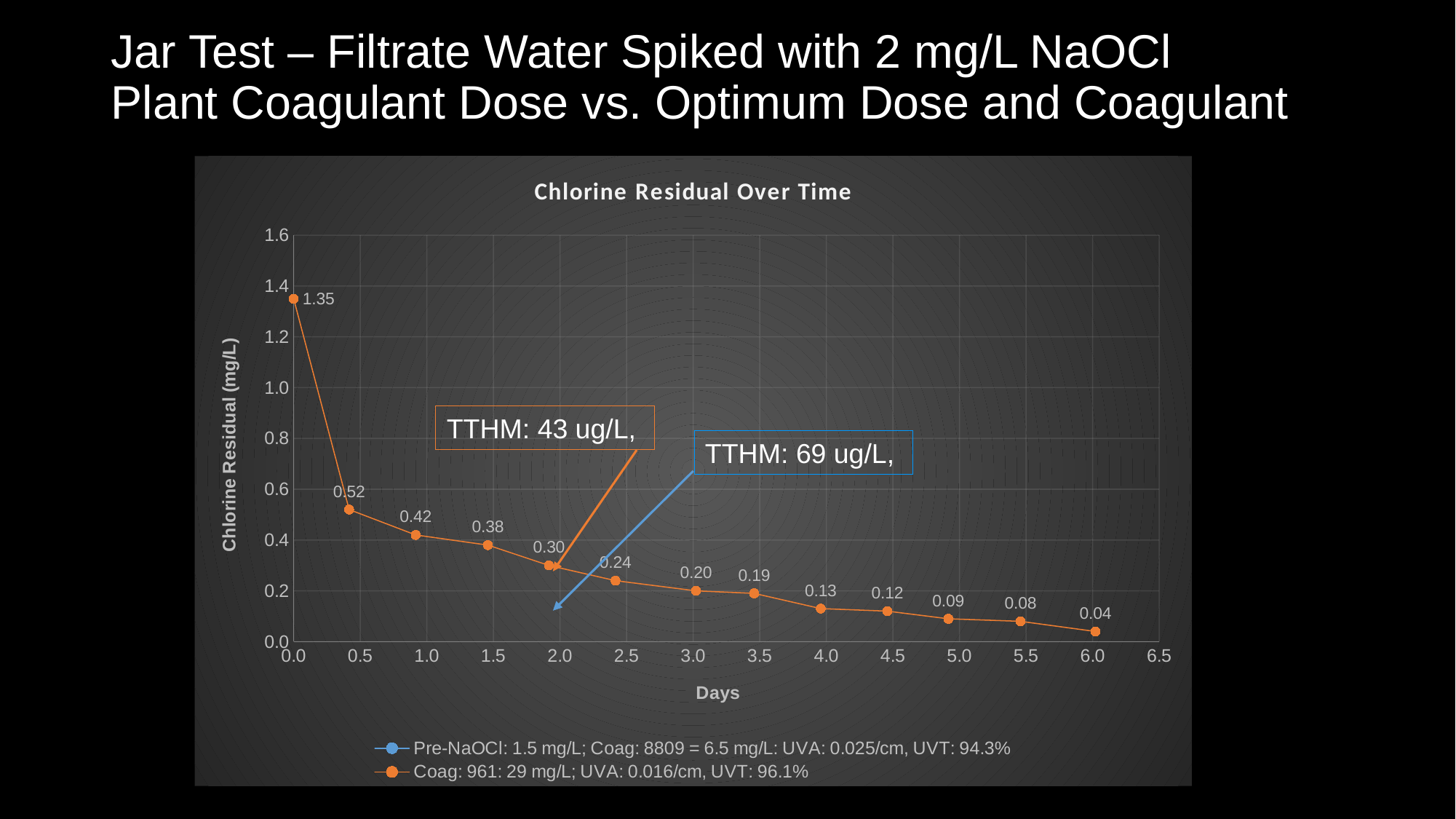
What is the title of the chart? Chlorine Residual Over Time Do the chlorine residual values rise or fall as the days increase? Fall What is the highest chlorine residual value plotted on the chart? 1.35 What is the difference between the second data point (0.52) and the third data point (0.42)? 0.10 What is the difference between the first data point (1.35) and the last data point (0.04)? 1.31 What is the chlorine residual value of the first data point, at day 0.0? 1.35 How many data points are plotted on the orange line? 13 Which is larger, the value of the second data point or the value of the fifth data point? The second data point (0.52) What is the lowest chlorine residual value plotted on the chart? 0.04 How many series does the chart legend list? 2 What is the chlorine residual value of the last data point, at day 6.0? 0.04 What type of chart is shown on the slide? Line chart